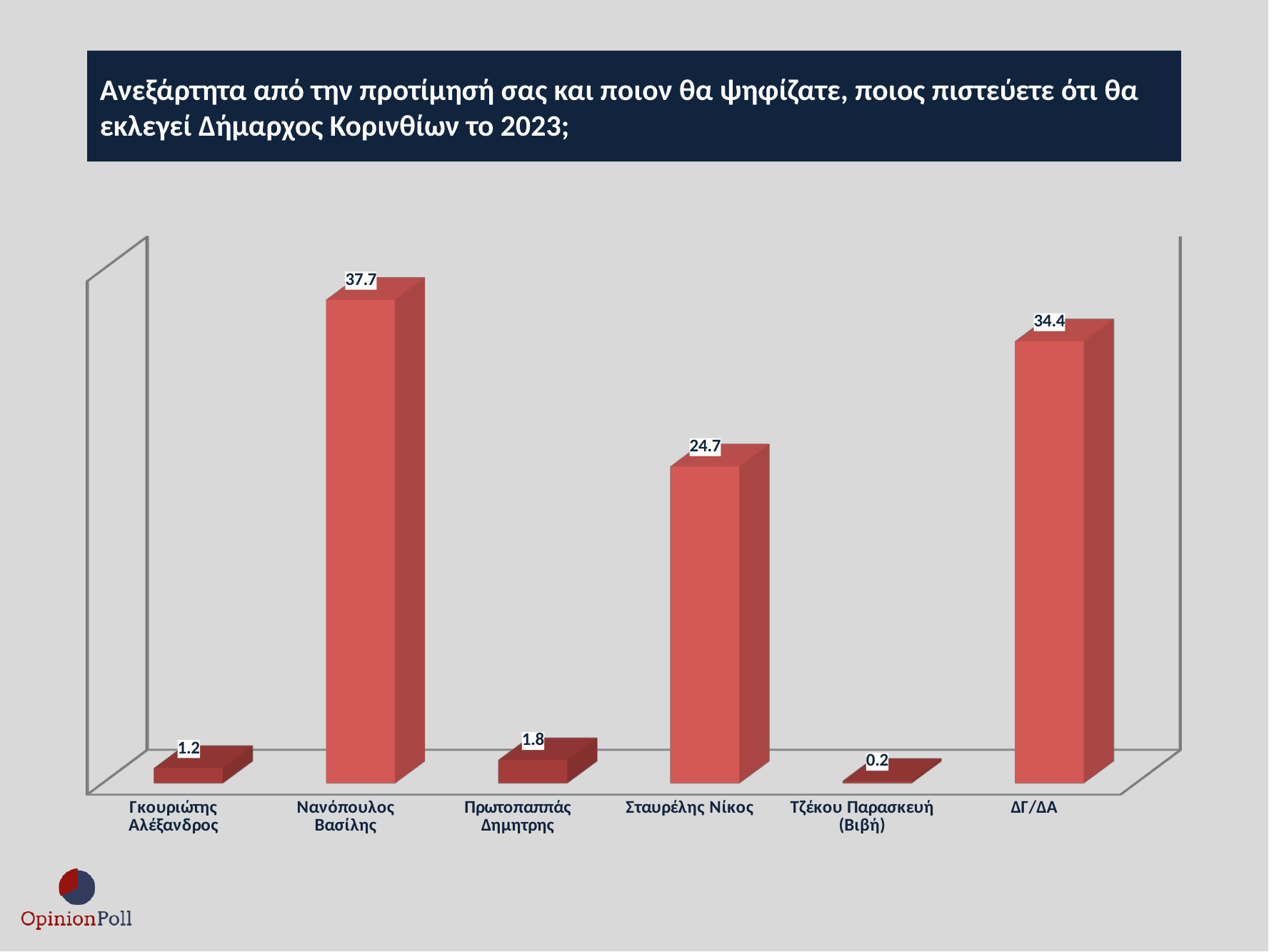
What kind of chart is shown on the slide? Bar chart Which is larger, the value for Σταυρέλης Νίκος or the value for ΔΓ/ΔΑ? ΔΓ/ΔΑ Which category has the lowest value? Τζέκου Παρασκευή (Βιβή) What is the difference between the values for Σταυρέλης Νίκος and Πρωτοπαππάς Δημήτρης? 22.9 What is the difference between the values for Νανόπουλος Βασίλης and ΔΓ/ΔΑ? 3.3 How many categories are shown on the chart? 6 What is the value for Τζέκου Παρασκευή (Βιβή)? 0.2 What is the value for Γκουριώτης Αλέξανδρος? 1.2 Which category has the highest value? Νανόπουλος Βασίλης What is the value for ΔΓ/ΔΑ? 34.4 What is the value for Νανόπουλος Βασίλης? 37.7 What is the value for Σταυρέλης Νίκος? 24.7